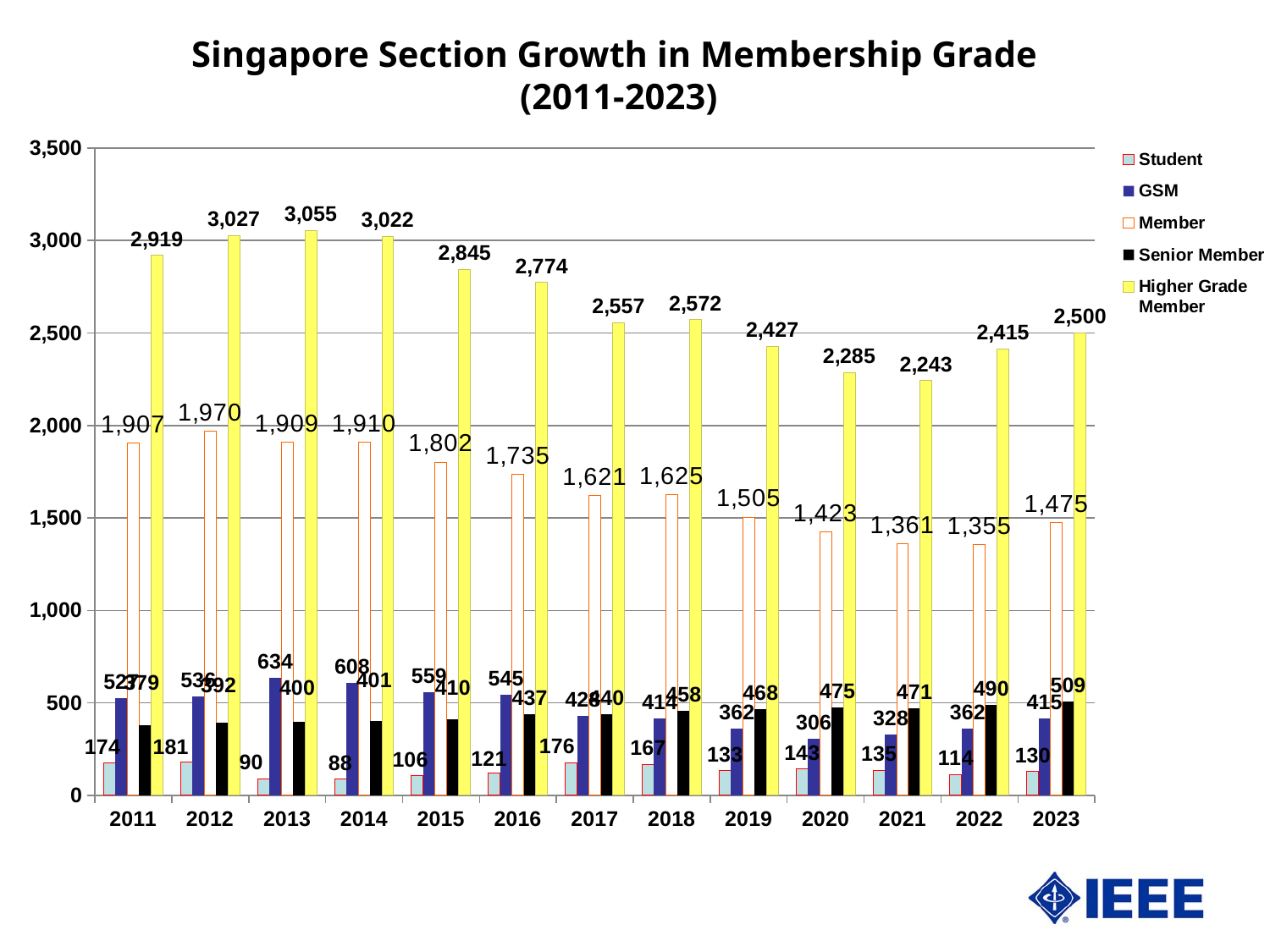
Which is larger in 2013, the GSM value or the Senior Member value? GSM What kind of chart is shown on the slide? Bar chart What is the difference between the Higher Grade Member values for 2023 and 2022? 85 In which year is the Higher Grade Member value lowest? 2021 How many years are shown on the x axis? 13 What is the Member value for 2012? 1,970 What is the Student value for 2014? 88 How many series does the legend list? 5 What is the Senior Member value for 2023? 509 In which year is the Higher Grade Member value highest? 2013 Is the Member value for 2023 greater or less than 1,500? less What is the Higher Grade Member value for 2013? 3,055